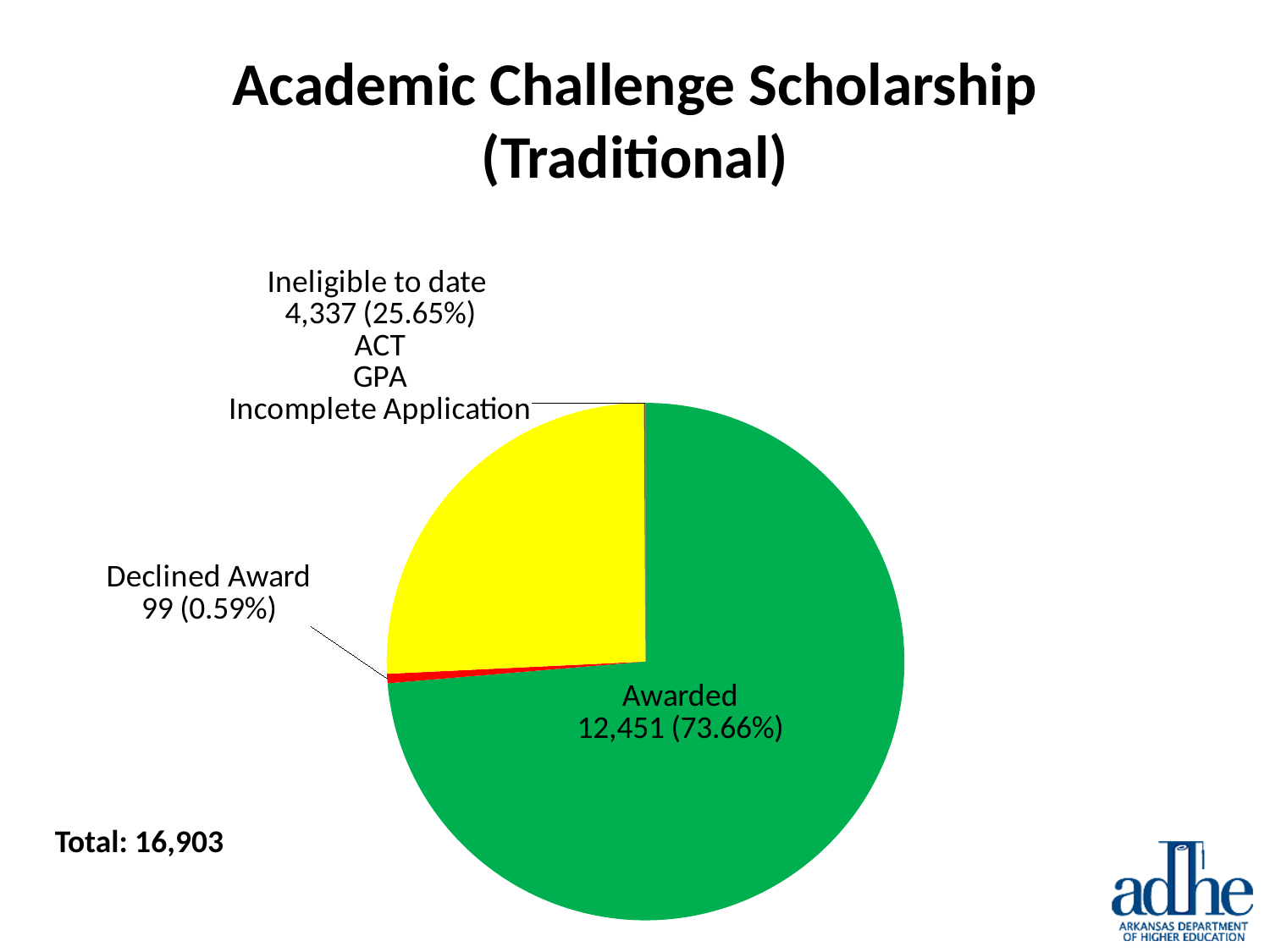
What is the value for Awarded? 12,451 What is the value for Declined Award? 99 What kind of chart is shown on the slide? Pie chart What is the difference between the Awarded and Ineligible to date values? 8,114 What is the title of the chart? Academic Challenge Scholarship (Traditional) Which category has the largest slice? Awarded What is the value for Ineligible to date? 4,337 What share of the pie does Declined Award represent? 0.59% What share of the pie does Awarded represent? 73.66% What share of the pie does Ineligible to date represent? 25.65%